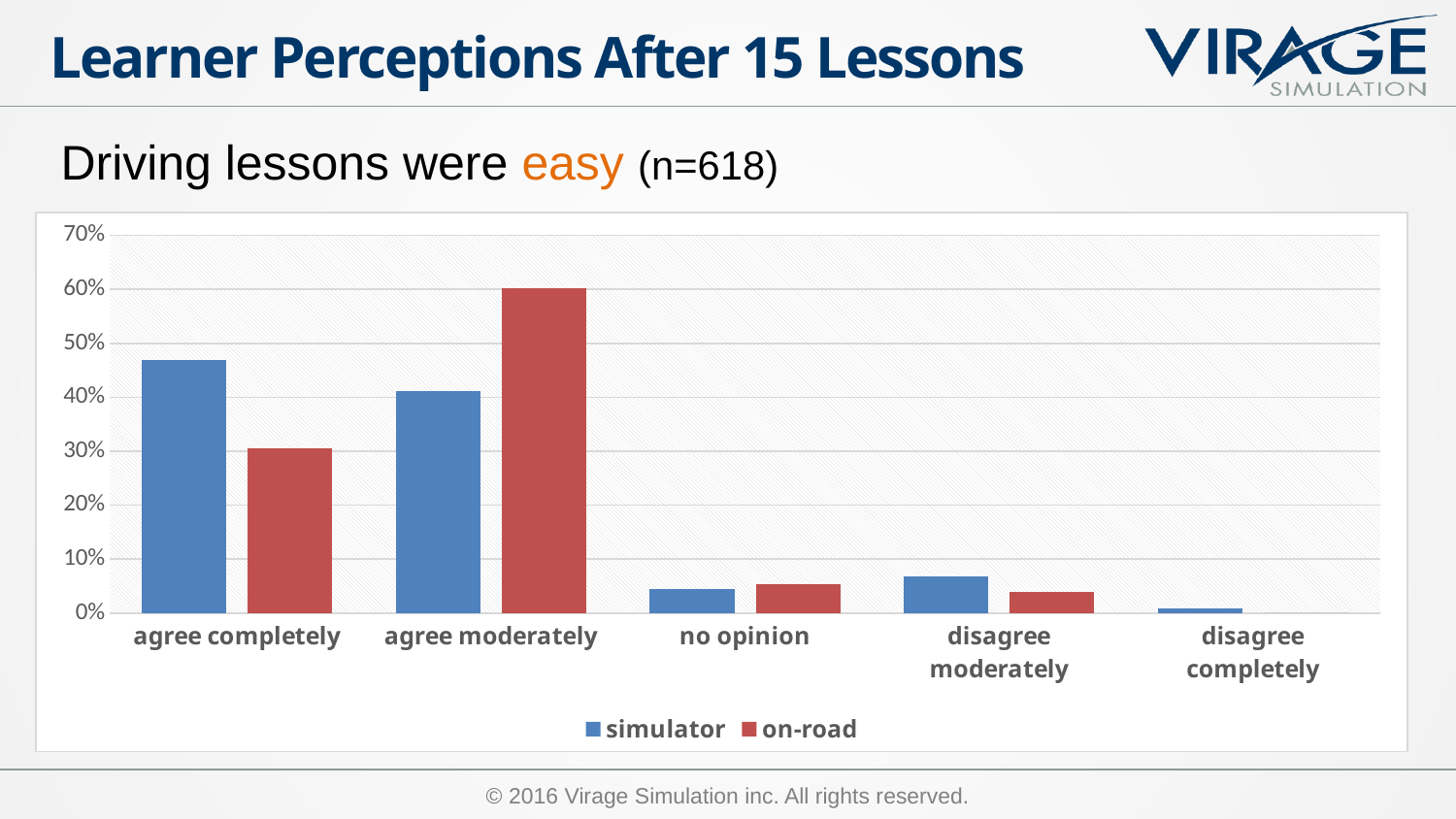
For 'agree moderately', which series has the larger value, simulator or on-road? on-road Is the on-road value for 'agree moderately' greater or less than 50%? greater How many series does the legend list? 2 What kind of chart is shown on the slide? bar chart Which category has the highest on-road value? agree moderately What is the sample size (n) stated in the chart's subtitle? 618 How many response categories are shown on the x axis? 5 Is the simulator value for 'agree completely' greater or less than 40%? greater For 'agree completely', which series has the larger value, simulator or on-road? simulator Which category has the lowest simulator value? disagree completely Which category has the highest simulator value? agree completely Is the on-road value for 'agree completely' greater or less than 40%? less